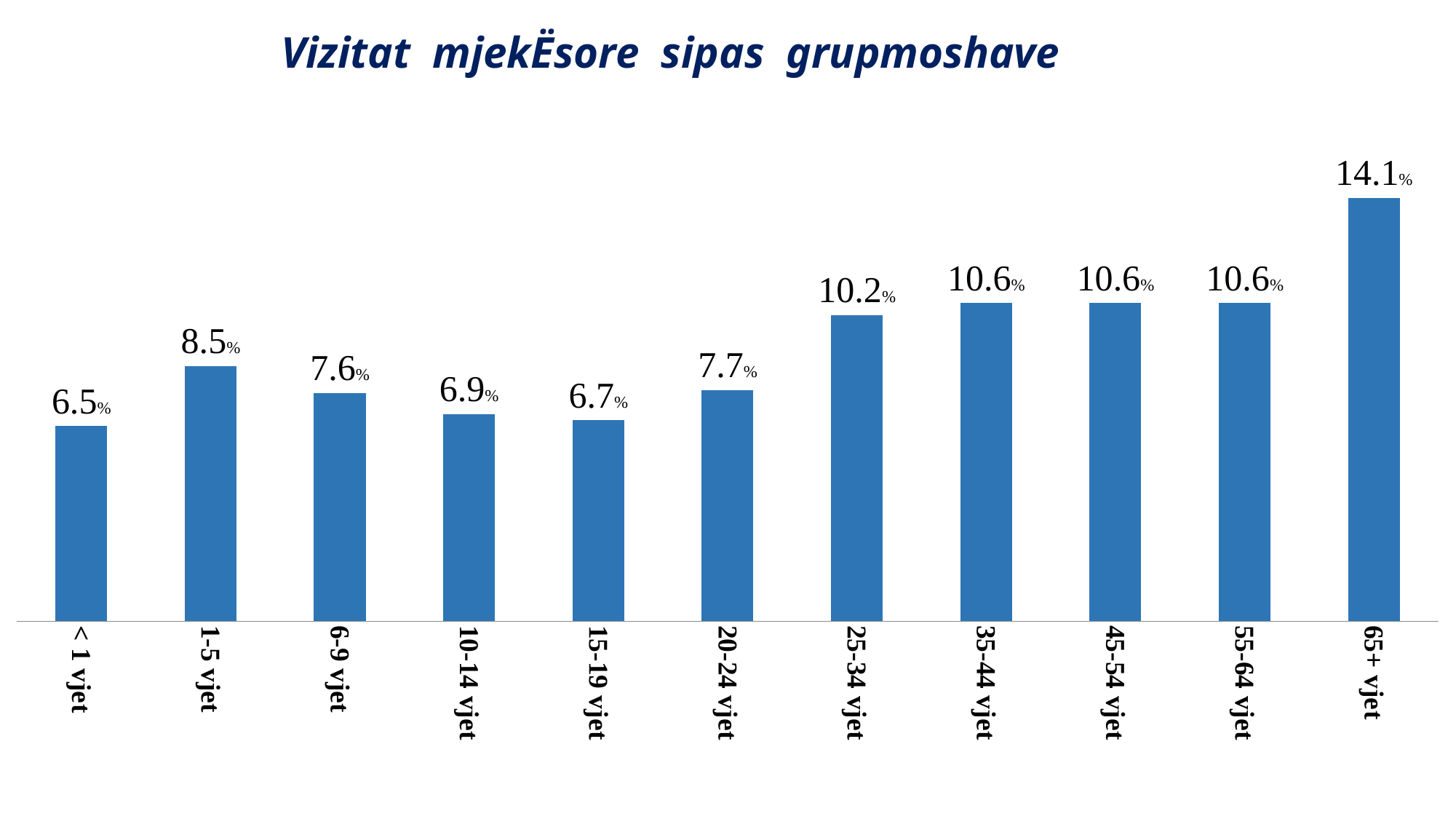
How many age groups are shown in the chart? 11 What is the difference between the values for 65+ vjet and < 1 vjet? 7.6% What is the value for the 25-34 vjet age group? 10.2% What is the value for the 65+ vjet age group? 14.1% What is the value for the 1-5 vjet age group? 8.5% What is the difference between the values for 1-5 vjet and 6-9 vjet? 0.9% Which age group has the highest value? 65+ vjet What is the value for the 15-19 vjet age group? 6.7% Which is larger, the value for 20-24 vjet or the value for 10-14 vjet? 20-24 vjet Which age group has the lowest value? < 1 vjet What kind of chart is shown on the slide? Bar chart What is the title of the chart? Vizitat mjekËsore sipas grupmoshave